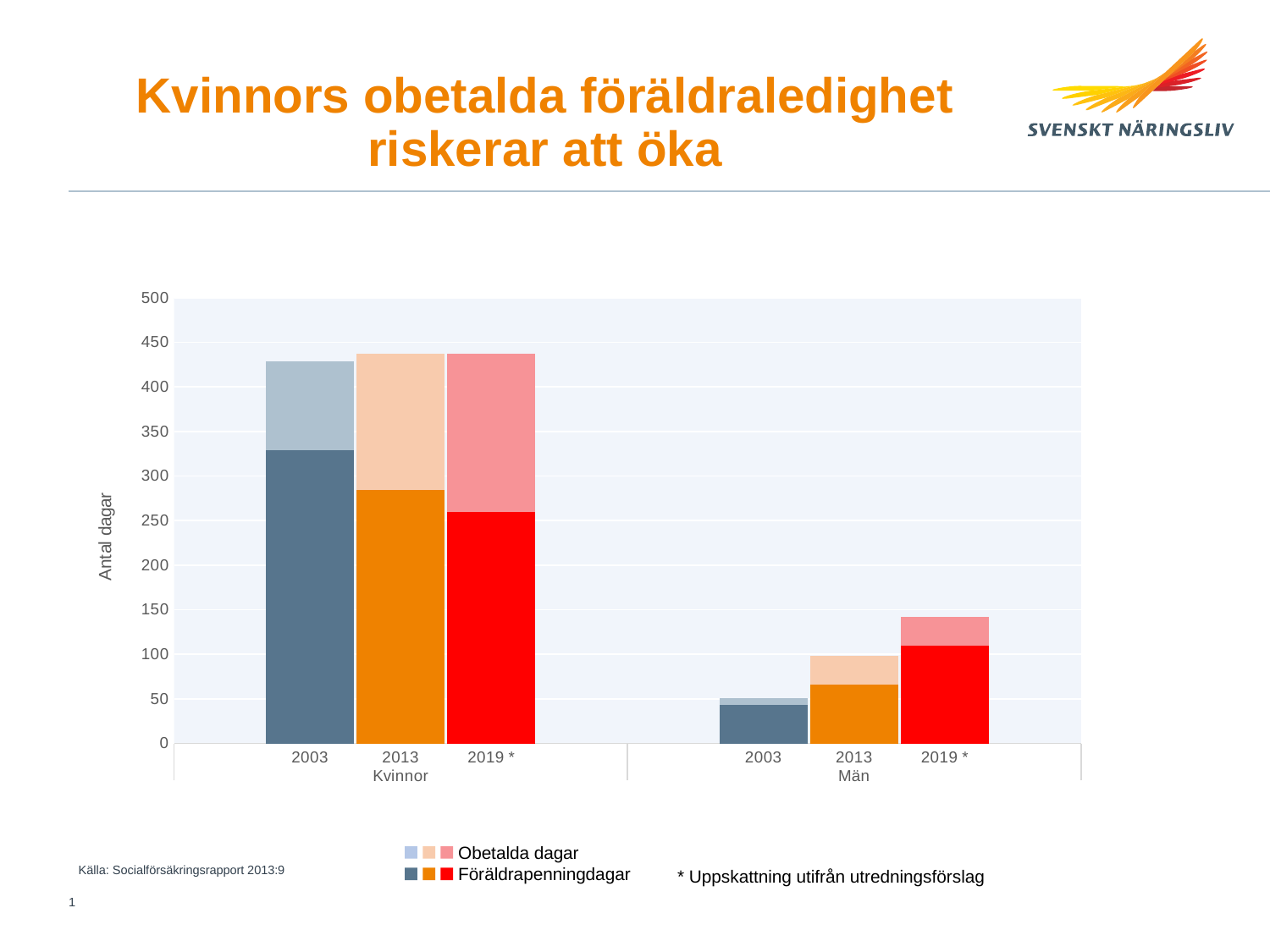
What is the label on the vertical axis? Antal dagar Is the total height of the Män 2003 bar greater or less than 100? less Which bar has the highest Föräldrapenningdagar value? Kvinnor 2003 How many bars are plotted in the chart? 6 How many series does the legend list? 2 What kind of chart is shown on the slide? Stacked bar chart Do the Föräldrapenningdagar values for Kvinnor rise or fall from 2003 to 2019 *? fall Do the Föräldrapenningdagar values for Män rise or fall from 2003 to 2019 *? rise Is the Föräldrapenningdagar value for Kvinnor in 2003 greater or less than 300? greater Which bar has the lowest total height? Män 2003 Is the Föräldrapenningdagar value for Kvinnor in 2019 * greater or less than 300? less